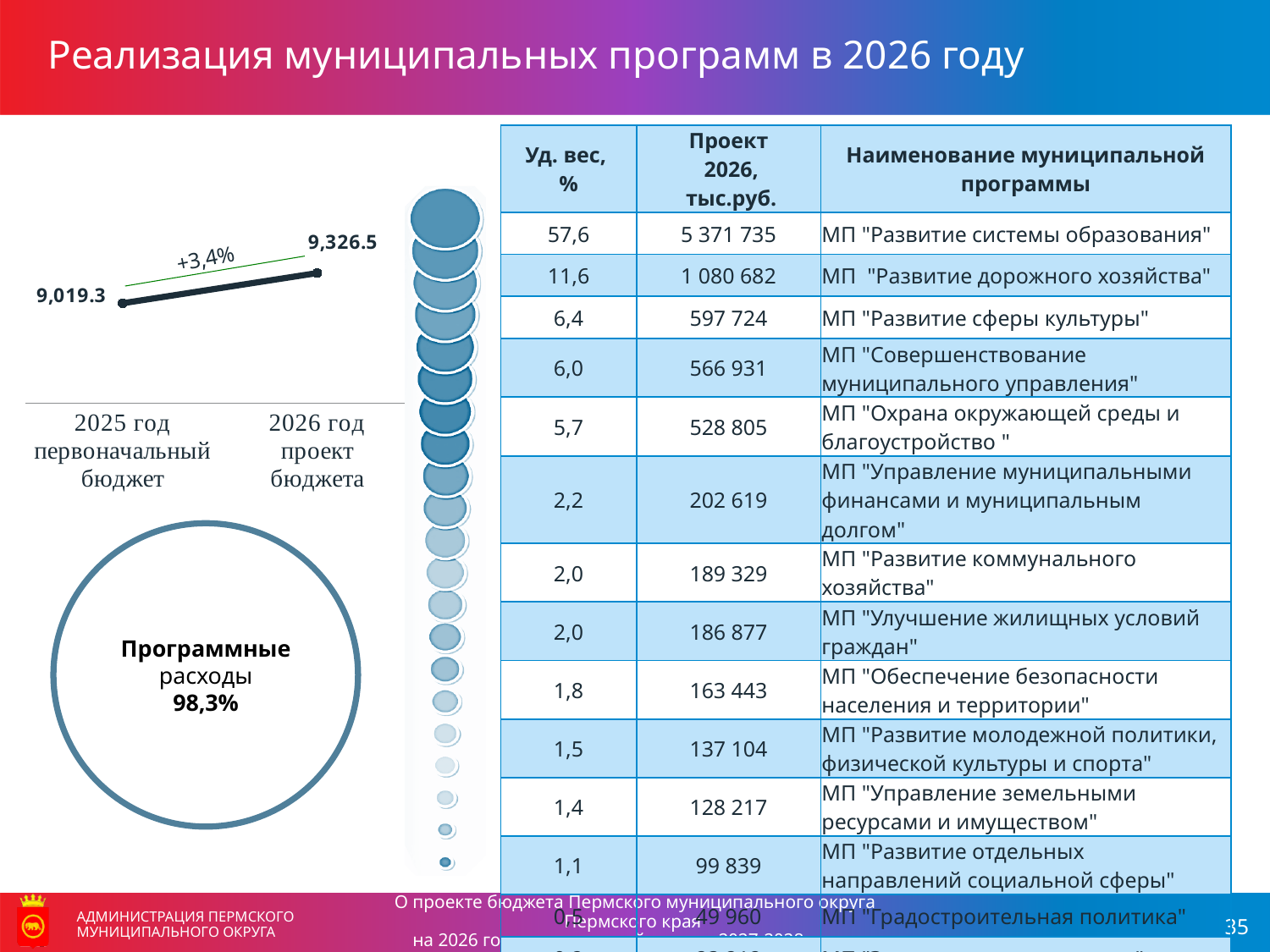
What share of expenditures is labelled as Программные расходы in the circle on the slide? 98,3% Is the value for 2026 год проект бюджета larger or smaller than the value for 2025 год первоначальный бюджет? larger What value is shown for 2026 год проект бюджета on the line chart? 9,326.5 What percentage change is labelled on the line chart between 2025 and 2026? +3,4% What value is shown for 2025 год первоначальный бюджет on the line chart? 9,019.3 Which of the two points on the line chart has the lower value? 2025 год первоначальный бюджет What kind of chart is used to show the 2025 and 2026 budget values? line chart What is the difference between the 2026 and 2025 values on the line chart? 307.2 Which of the two points on the line chart has the higher value? 2026 год проект бюджета Does the line chart rise or fall from 2025 to 2026? rises How many data points are plotted on the line chart? 2